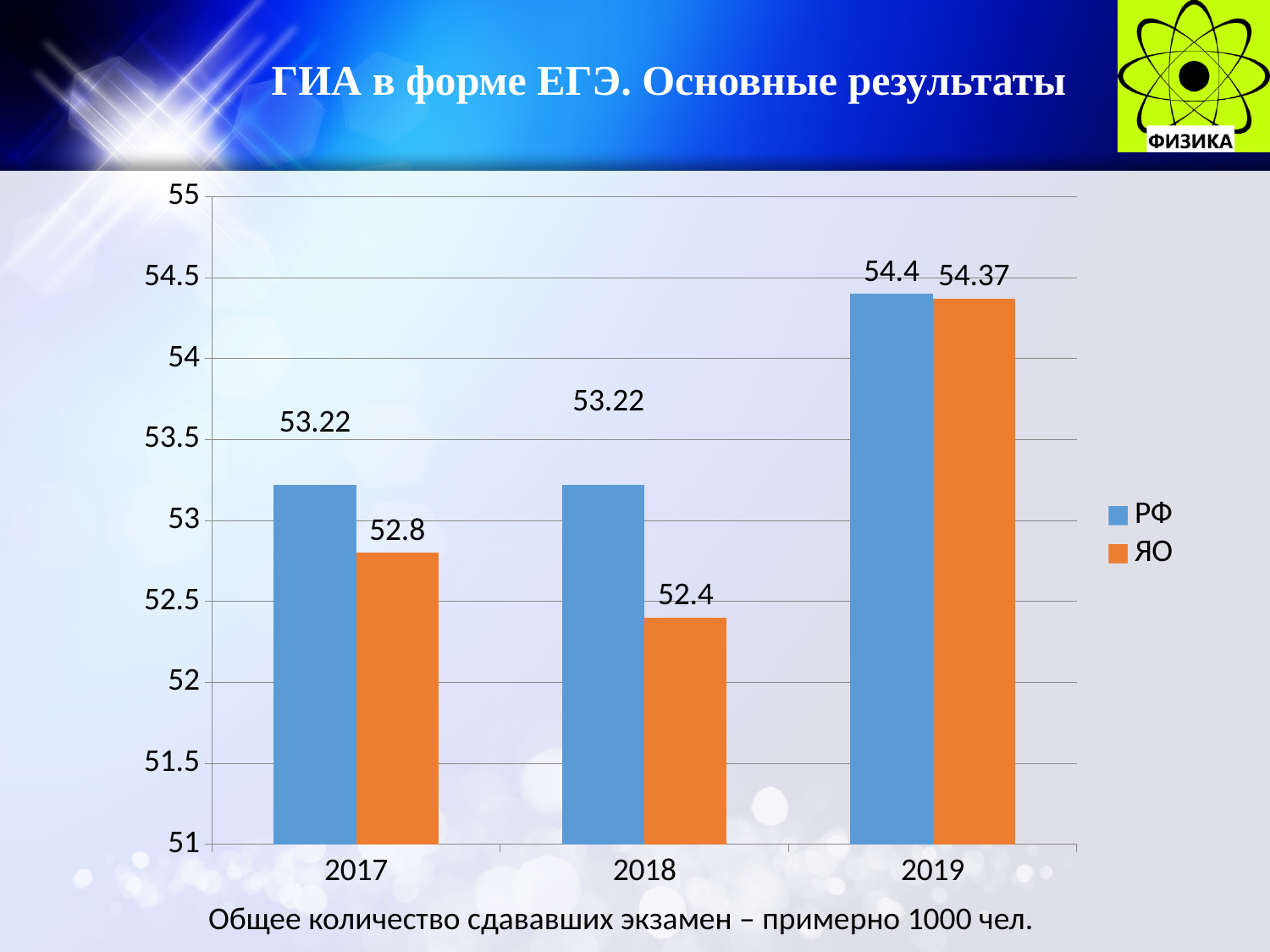
What is the difference between the РФ and ЯО values in 2018? 0.82 What is the value for ЯО in 2019? 54.37 What is the value for ЯО in 2018? 52.4 In which year is the ЯО value highest? 2019 Which is larger in 2017, the РФ value or the ЯО value? РФ How many years are shown on the x axis? 3 Is the value for ЯО in 2017 greater or less than 53? less In which year is the ЯО value lowest? 2018 What kind of chart is shown on the slide? bar chart How many series does the legend list? 2 What is the value for РФ in 2019? 54.4 What is the value for РФ in 2017? 53.22